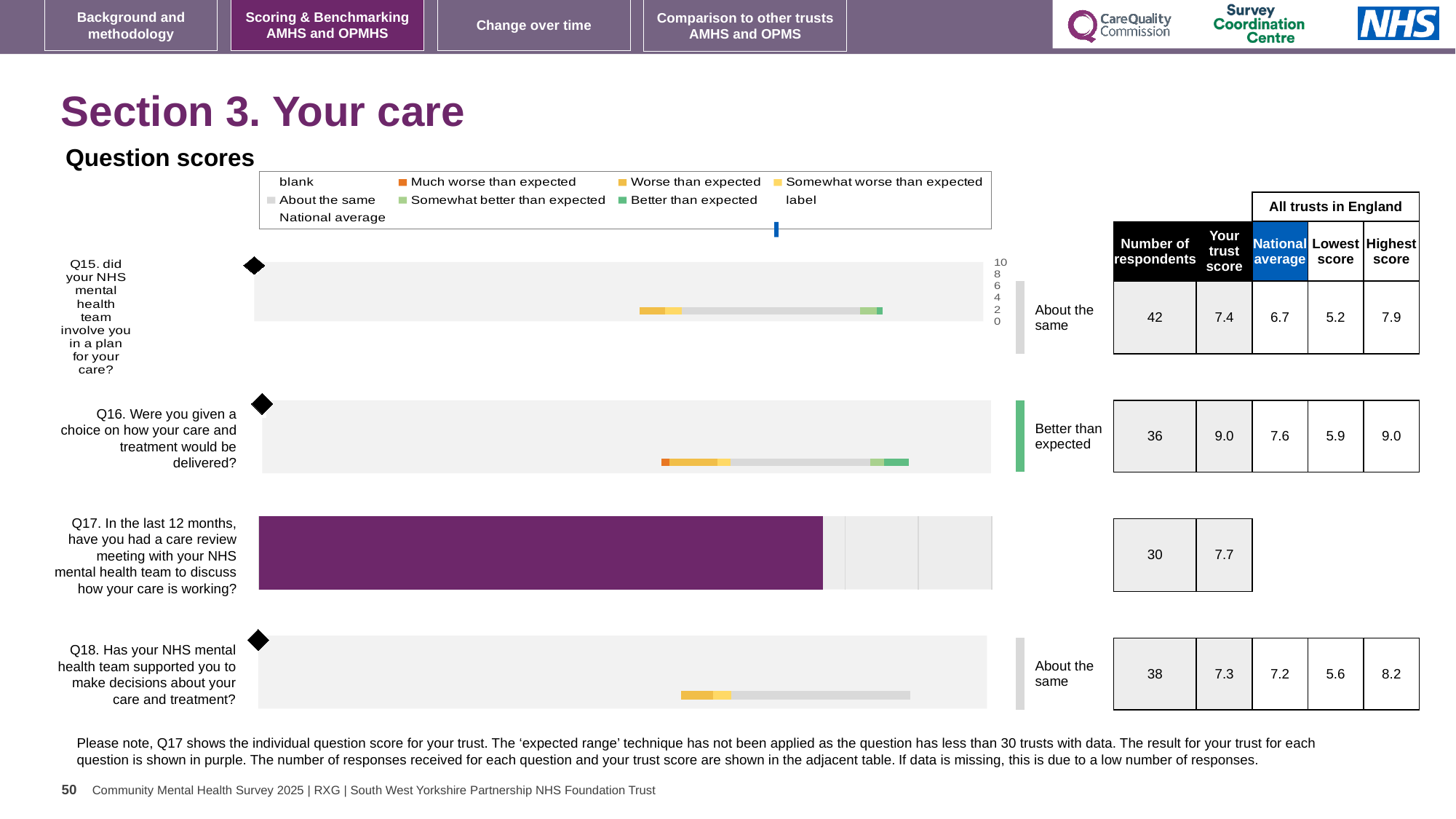
What colour is the bar for Q17, the question where the expected range technique has not been applied? purple How many questions (Q15 to Q18) are plotted in the question scores chart? 4 How many respondents answered Q18 (Has your NHS mental health team supported you to make decisions about your care and treatment?)? 38 Is the trust score for Q15 larger than the trust score for Q18? Q15 (7.4) is larger What is the difference between the trust score and the national average for Q16? 1.4 What benchmark label is shown for Q16? Better than expected What is the trust score for Q16 (Were you given a choice on how your care and treatment would be delivered?)? 9.0 Which question has the highest trust score? Q16 What is the national average for Q15 (did your NHS mental health team involve you in a plan for your care?)? 6.7 What is the highest score among all trusts in England for Q18? 8.2 Which question has the lowest number of respondents? Q17 What type of chart is used to show the question scores on this slide? bar chart